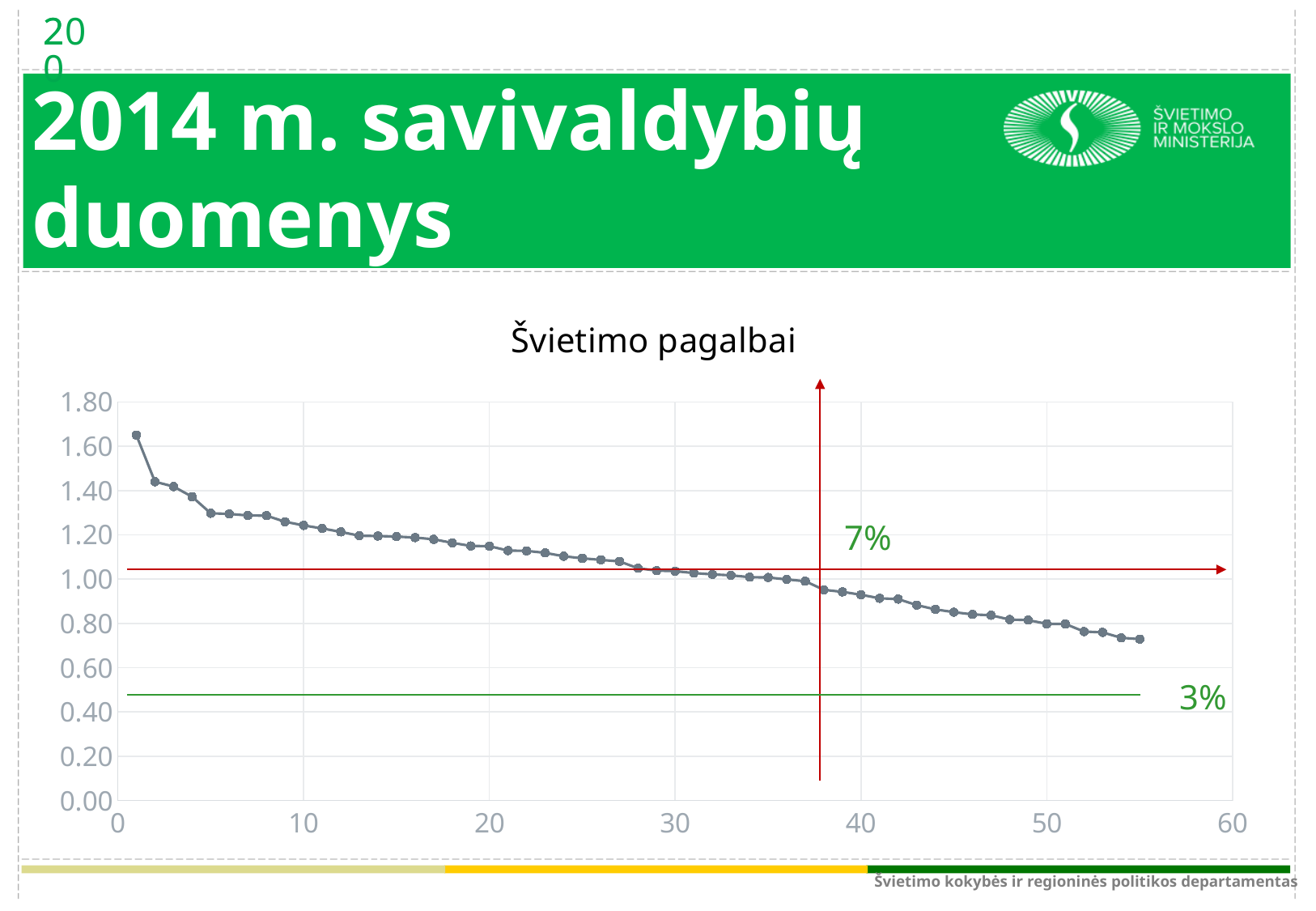
Is the value of the point at x = 2 greater or less than 1.40? greater Is the value of the point at x = 40 greater or less than 1.00? less Which plotted point has the lowest value? the last point (at about x = 55) Which plotted point has the highest value? the first point (x = 1) Is the value of the point at x = 5 greater or less than 1.20? greater What kind of chart is shown on the slide? line chart What percentage labels are written next to the two horizontal reference lines on the chart? 7% and 3% Do the plotted values rise or fall as the x axis increases? fall What is the title of the chart? Švietimo pagalbai